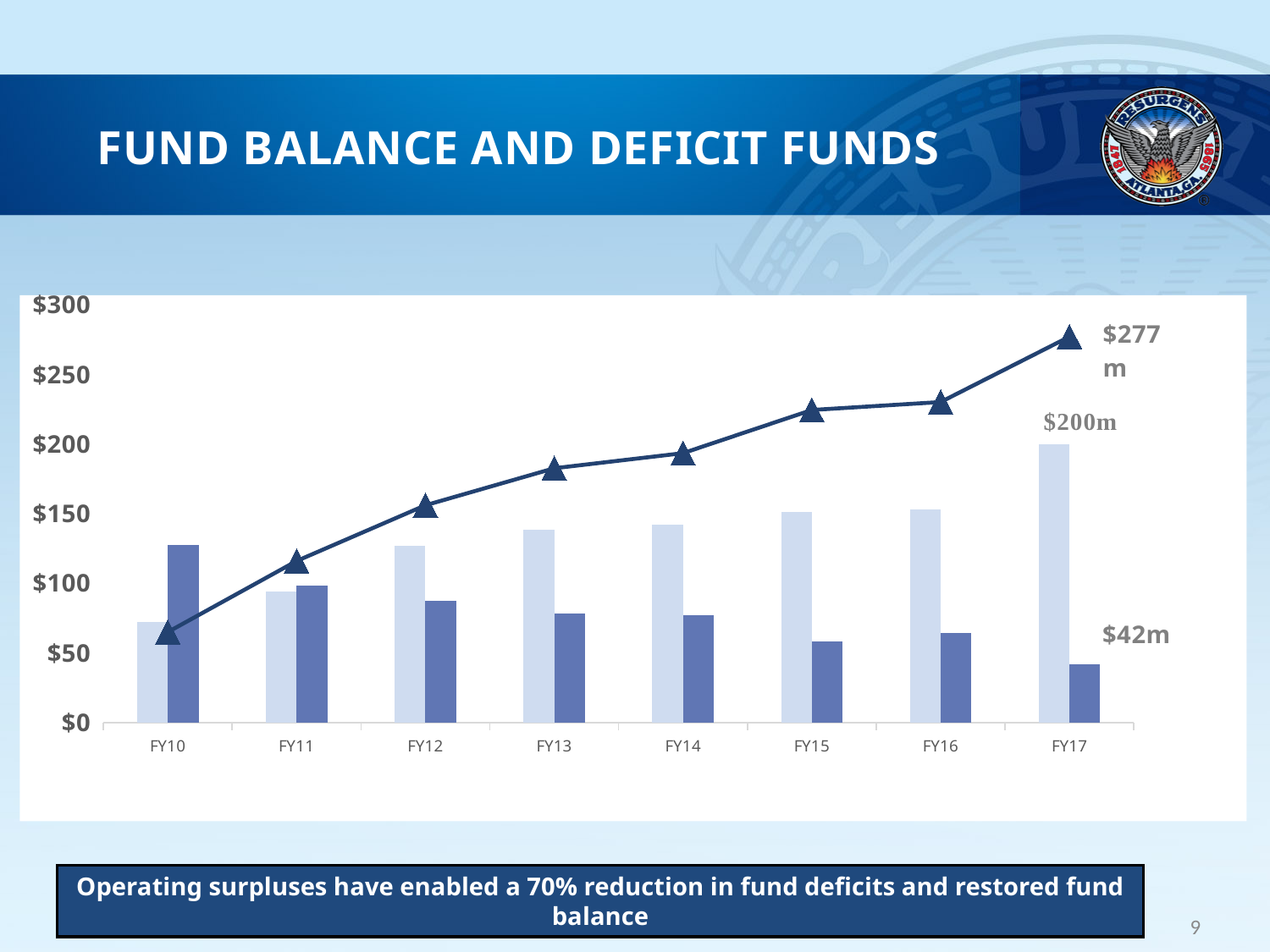
What value is labelled on the dark blue bar for FY17? $42m Is the value of the dark blue bar for FY10 greater or less than $100? greater Is the value of the light blue bar for FY10 greater or less than $100? less Which fiscal year has the tallest light blue bar? FY17 What value is labelled on the line marker for FY17? $277m Do the dark blue bars generally rise or fall from FY10 to FY17? Fall What is the difference between the light blue bar and the dark blue bar for FY17? $158m How many fiscal years are shown on the x axis? 8 Does the line with triangle markers rise or fall from FY10 to FY17? Rises What kind of chart is shown on the slide? Bar chart with a line What value is labelled on the light blue bar for FY17? $200m Which fiscal year has the shortest dark blue bar? FY17